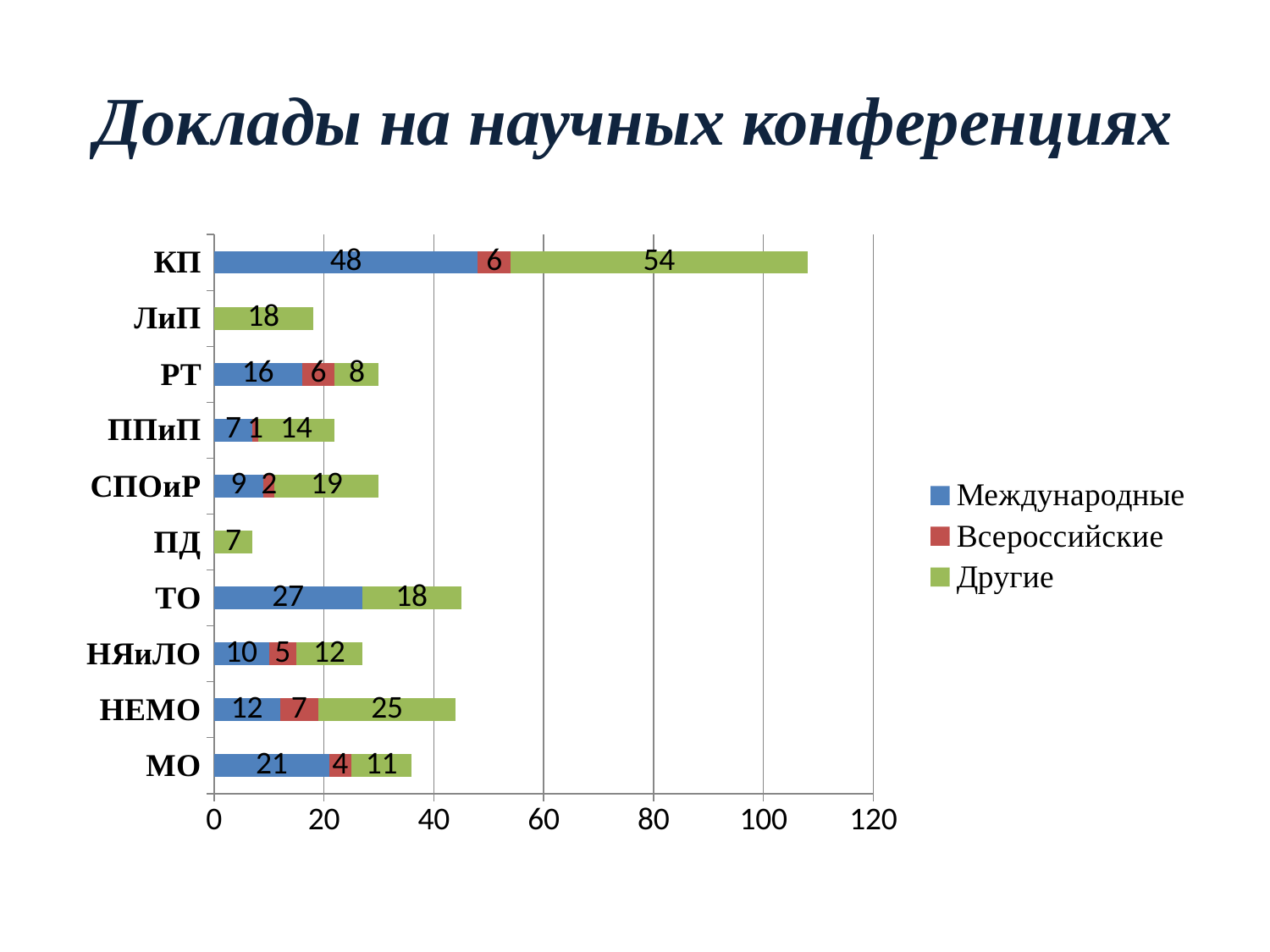
What is the value of Международные for КП? 48 What is the difference between the Другие values for КП and ТО? 36 What kind of chart is shown on the slide? Stacked bar chart Which category has the highest value for Международные? КП How many categories are shown on the y axis? 10 Which category has the lowest value for Всероссийские among those with a labelled Всероссийские segment? ППиП What is the value of Всероссийские for НЯиЛО? 5 What is the total of the stacked bar for РТ? 30 What is the value of Другие for НЕМО? 25 What is the total of the stacked bar for КП? 108 Which is larger: the Международные value for ТО or for МО? ТО How many series does the legend list? 3